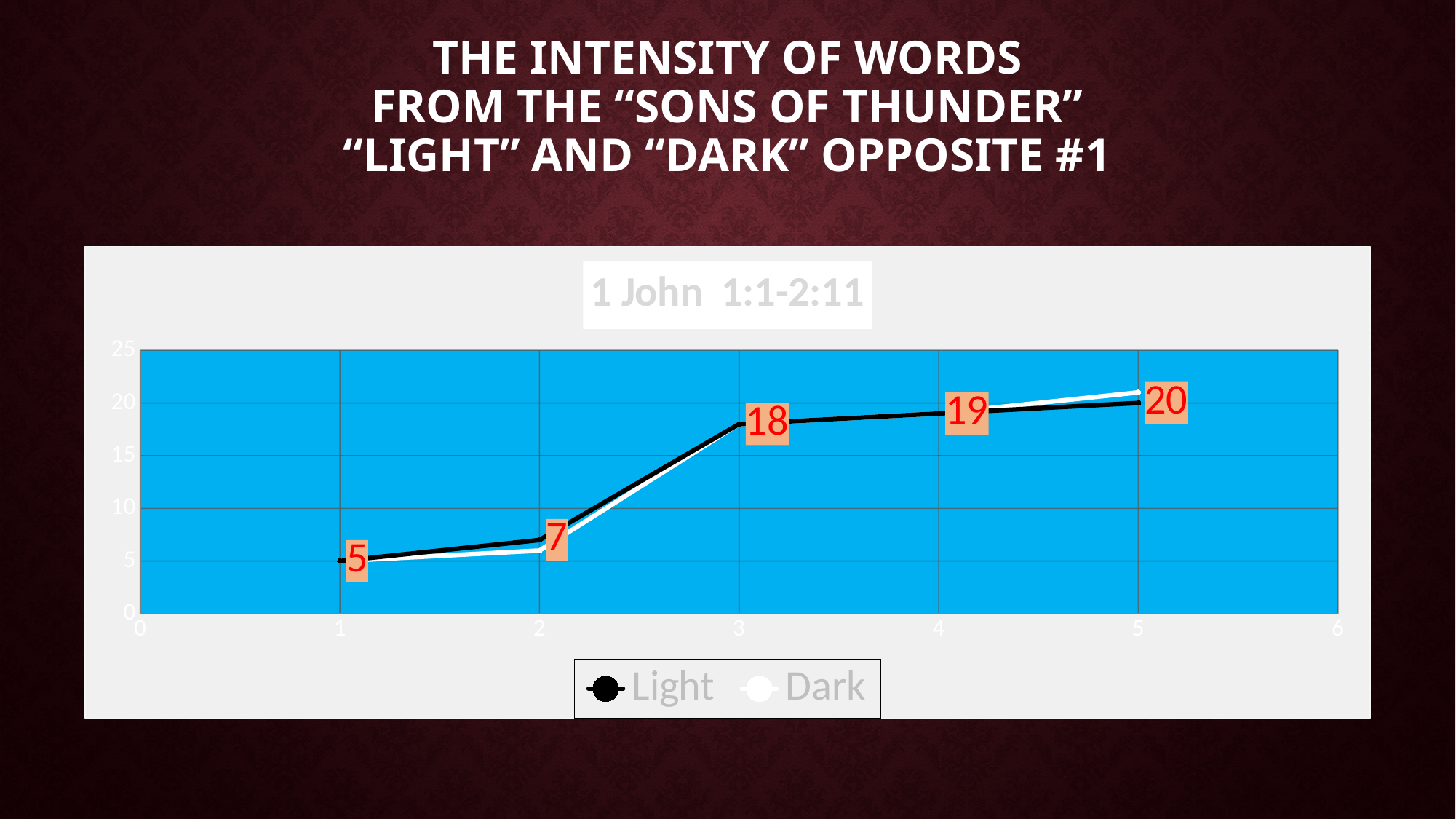
How many series does the chart legend list? 2 At which x position is the lowest labelled value? 1 Do the values rise or fall as x increases from 1 to 5? rise What is the title of the chart? 1 John 1:1-2:11 How many data points are plotted along each line? 5 What is the difference between the labelled values at x = 3 and x = 2? 11 What data label is shown at x = 3? 18 What data label is shown at x = 5? 20 What data label is shown at x = 1? 5 At which x position is the highest labelled value? 5 What are the names of the two series in the legend? Light and Dark What kind of chart is shown on the slide? line chart